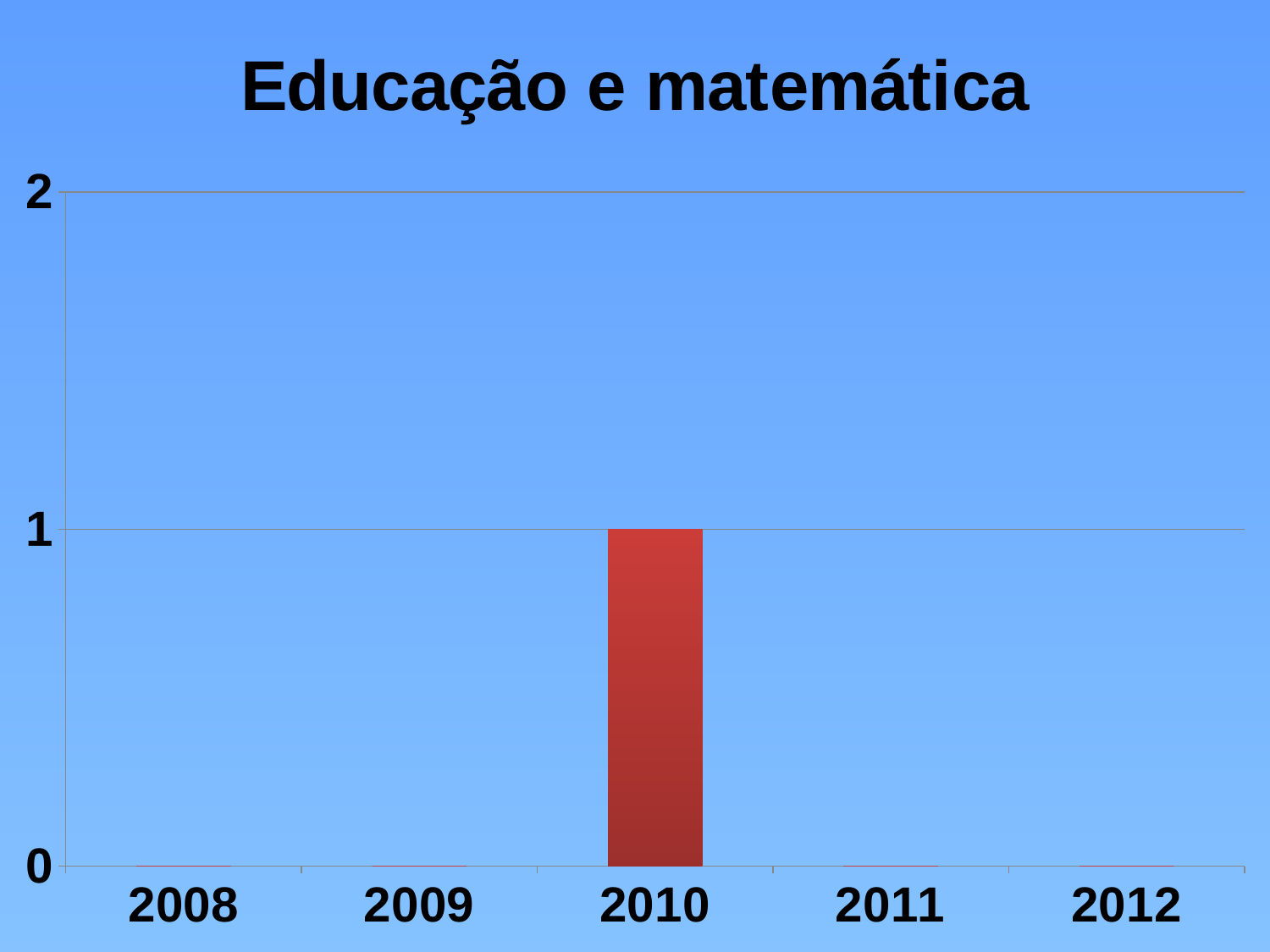
What is the title of the chart? Educação e matemática How many years are shown on the x axis of the chart? 5 What is the value for 2012 in the chart? 0 What is the value for 2008 in the chart? 0 What kind of chart is shown on the slide? bar chart Which year has the highest value in the chart? 2010 Is the value for 2010 greater or less than 2? less What is the highest value shown on the y axis? 2 What is the difference between the value for 2010 and the value for 2011? 1 What colour is the bar for 2010? red Which is larger, the value for 2010 or the value for 2009? 2010 What is the value for 2010 in the chart? 1